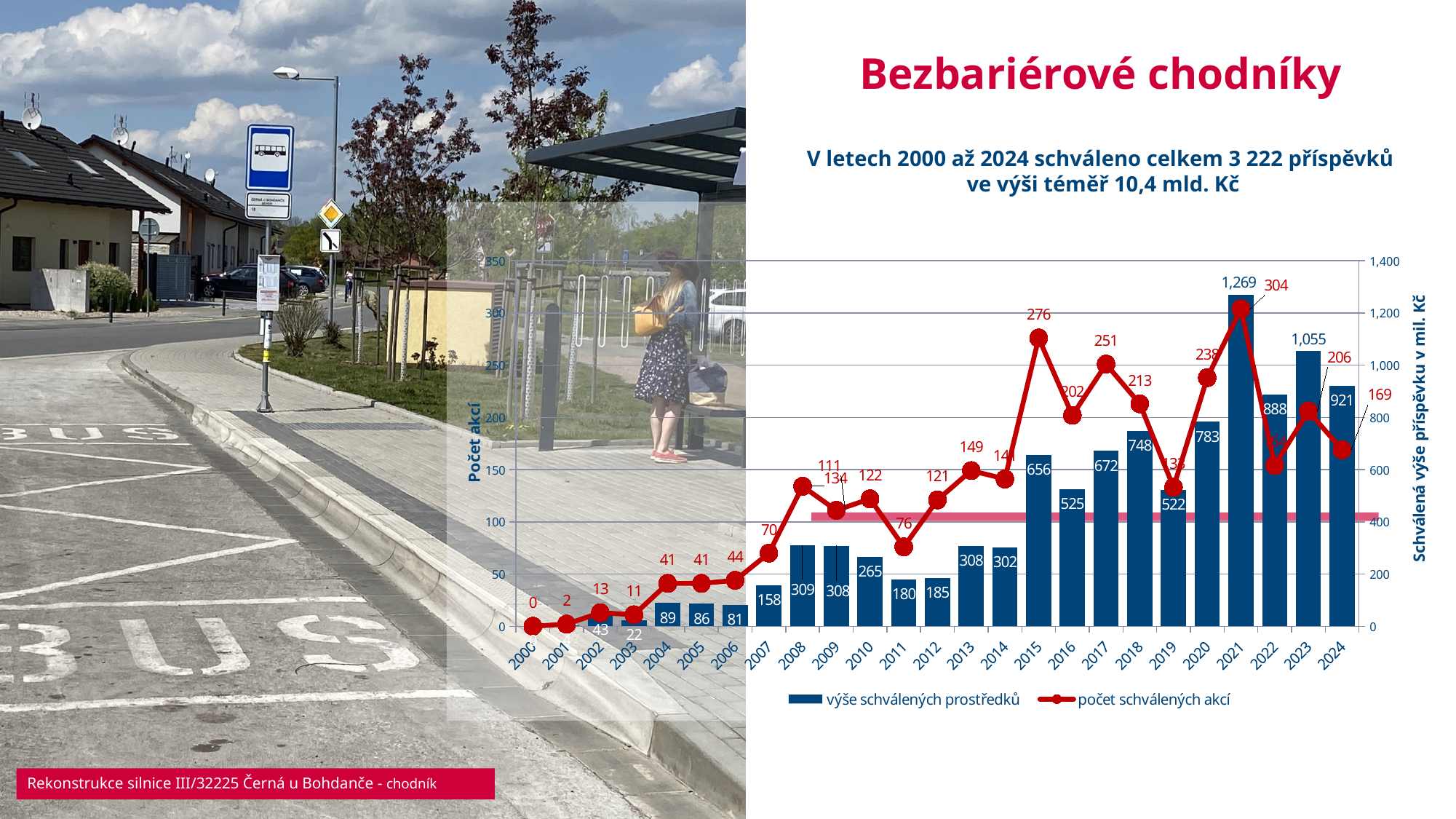
How many years are shown on the x axis of the chart? 25 In which year is the bar for výše schválených prostředků the highest? 2021 What kind of chart is shown on the slide? Combined bar and line chart How many series does the chart legend list? 2 Which year has the larger bar value, 2016 or 2017? 2017 Does the počet schválených akcí line rise or fall from 2000 to 2008? rise Is the bar value for 2000 greater or less than 200 on the right axis? less In which year is the počet schválených akcí line at its lowest? 2000 What is the value of the line (počet schválených akcí) for 2024? 169 What is the difference between the bar values for 2021 and 2023? 214 What is the value of the line (počet schválených akcí) for 2015? 276 What is the value of the bar (výše schválených prostředků) for 2021? 1,269